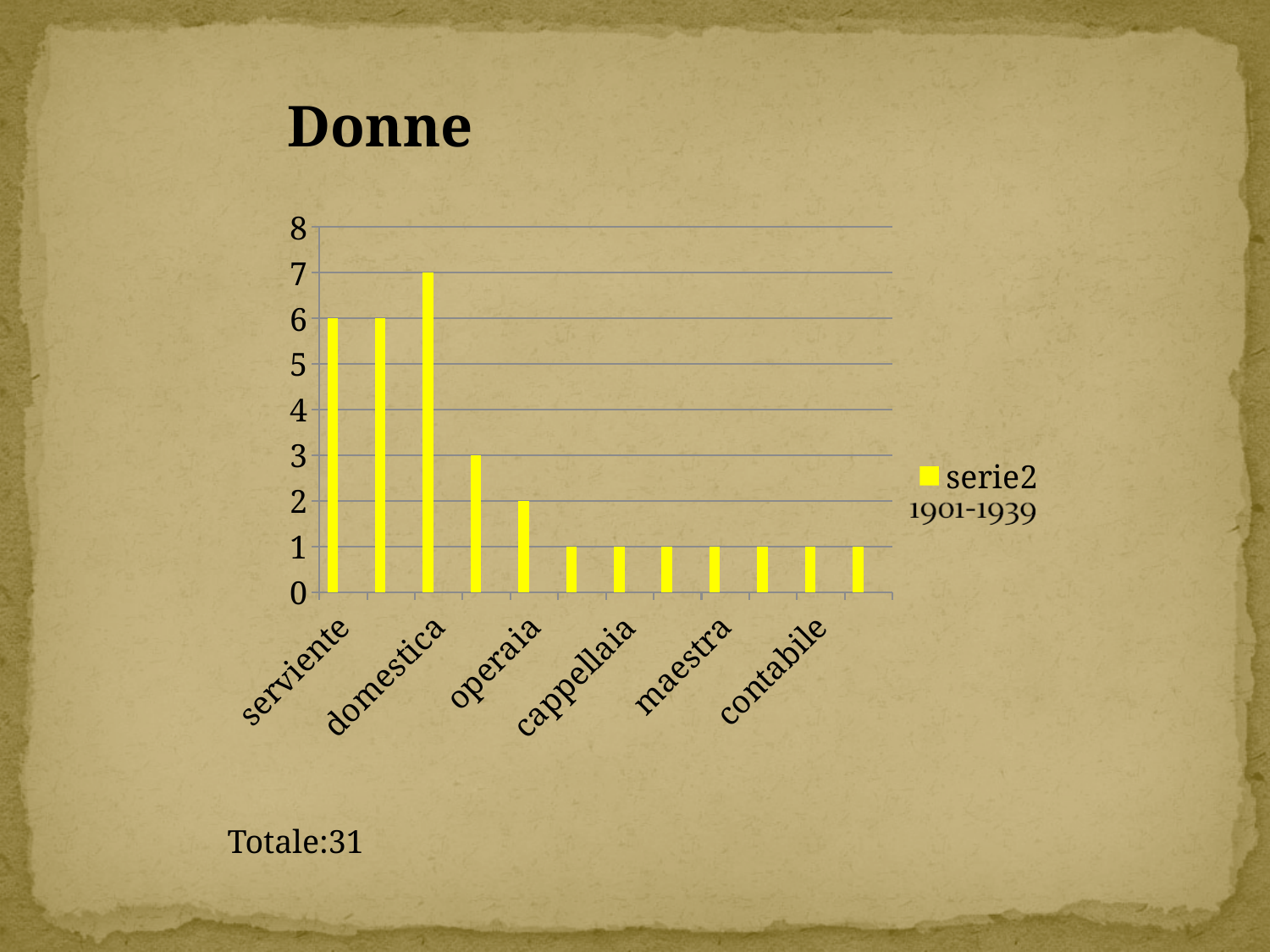
Which is larger, the value for serviente or the value for operaia? serviente What is the value for maestra? 1 How many series does the legend list? 1 What is the value for serviente? 6 Which labelled category has the highest value? domestica What is the value for domestica? 7 What is the difference between the values for domestica and serviente? 1 What is the title of the chart? Donne What is the value for operaia? 2 What kind of chart is shown on the slide? bar chart How many bars are plotted in the chart? 12 Do the values generally rise or fall from left to right along the x axis? fall